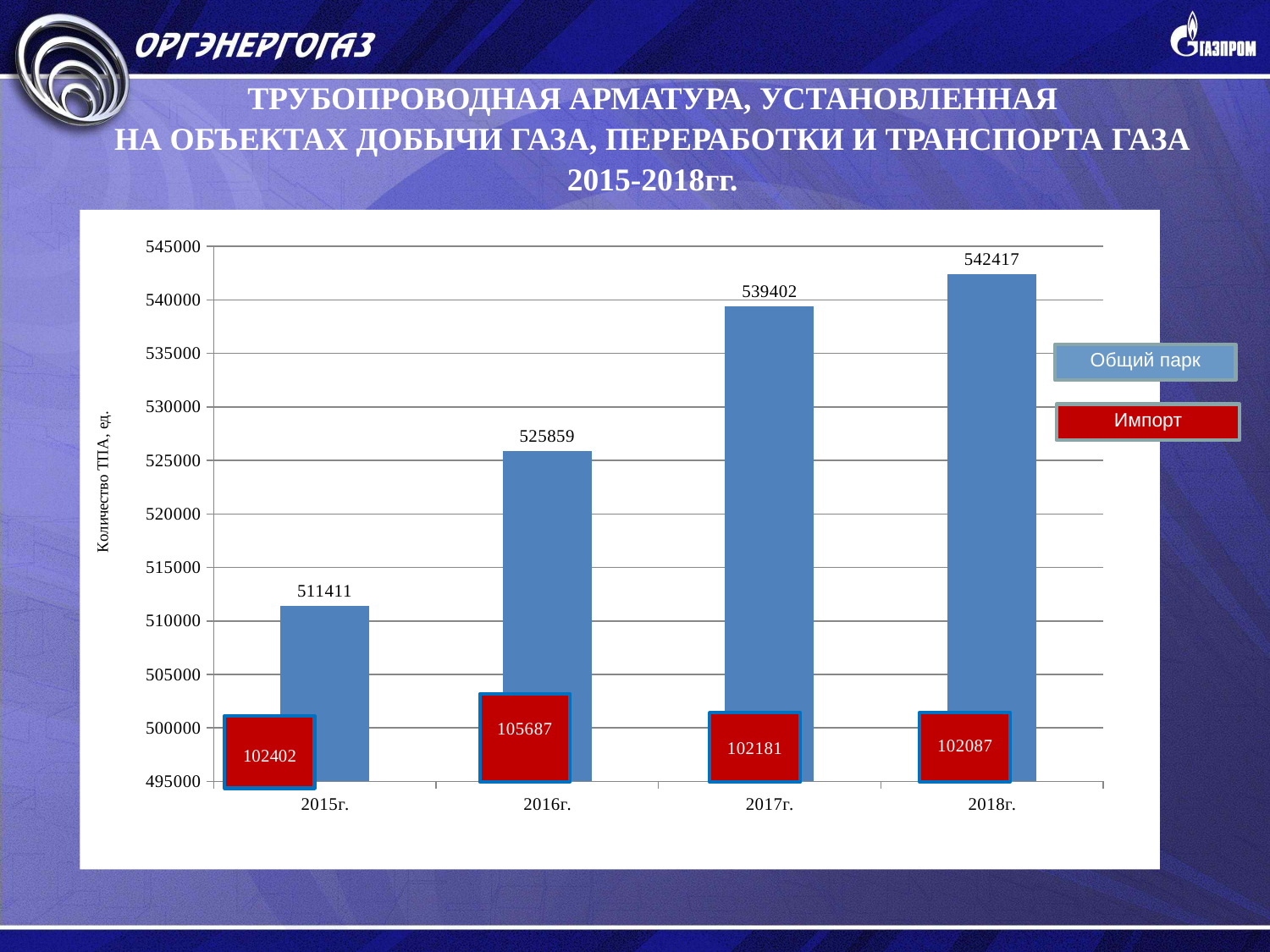
What type of chart is shown on the slide? Bar chart Which is larger, the Импорт value for 2016г. or for 2017г.? 2016г. What is the value of Общий парк for 2017г.? 539402 What is the difference between the Общий парк values for 2016г. and 2015г.? 14448 How many years are shown on the x axis? 4 Which year has the lowest Общий парк value? 2015г. What Импорт value is shown for 2016г.? 105687 What Импорт value is shown for 2018г.? 102087 Do the Общий парк values rise or fall from 2015г. to 2018г.? Rise What is the value of Общий парк for 2015г.? 511411 What is the difference between the Общий парк values for 2018г. and 2017г.? 3015 Which year has the highest Общий парк value? 2018г.